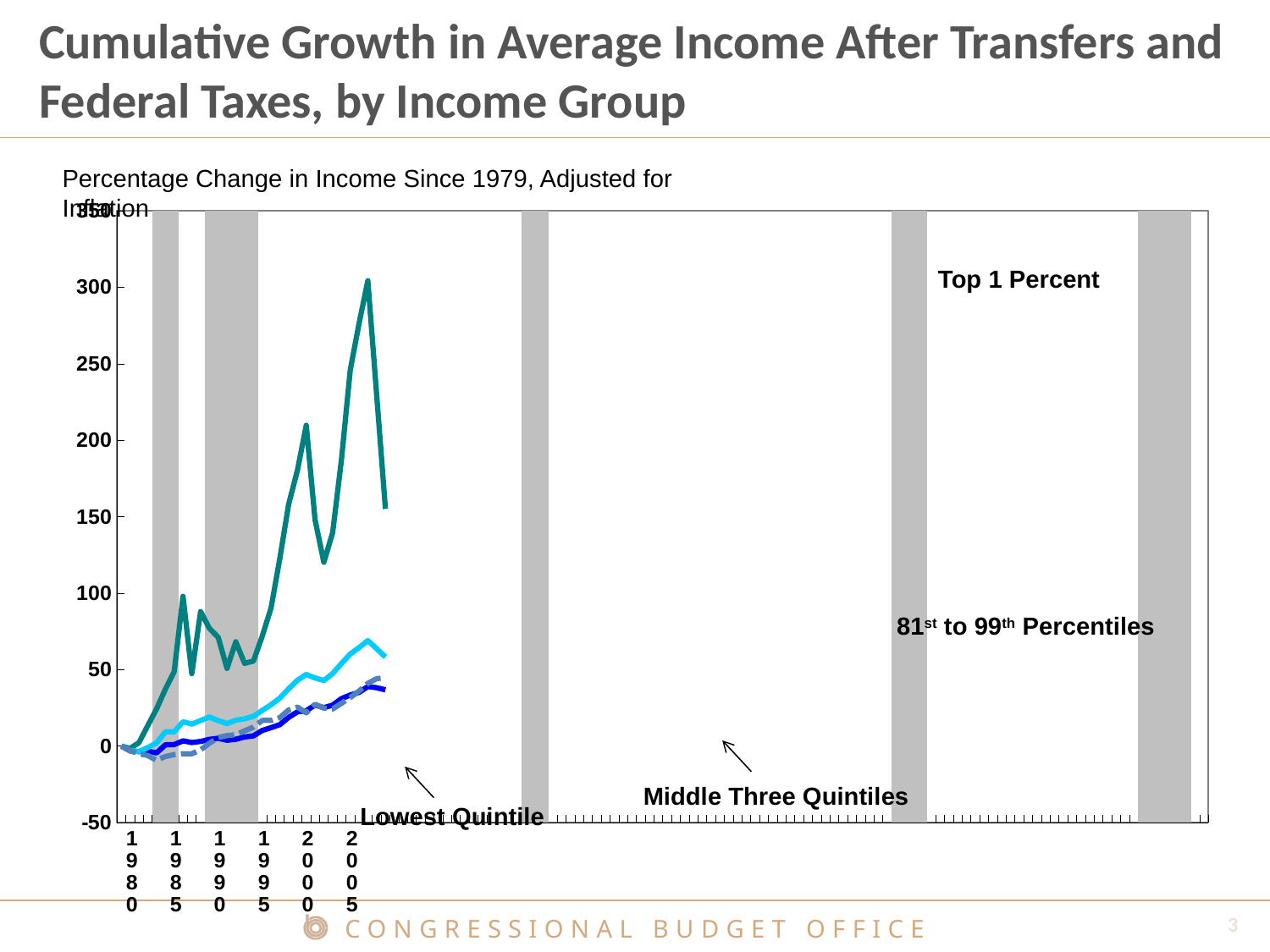
Is the final value of the Middle Three Quintiles line greater or less than 50? less Is the peak value of the 81st to 99th Percentiles line greater or less than 100? less What kind of chart is shown on the slide? line chart What is the title of the slide? Cumulative Growth in Average Income After Transfers and Federal Taxes, by Income Group Is the peak value of the 81st to 99th Percentiles line greater or less than 50? greater What is the highest value shown on the vertical axis? 350 Does the Top 1 Percent line generally rise or fall from 1980 onward? rise Which income group shows the highest cumulative growth on the chart? Top 1 Percent How many income groups are plotted as lines on the chart? 4 Which line reaches higher values: Top 1 Percent or 81st to 99th Percentiles? Top 1 Percent